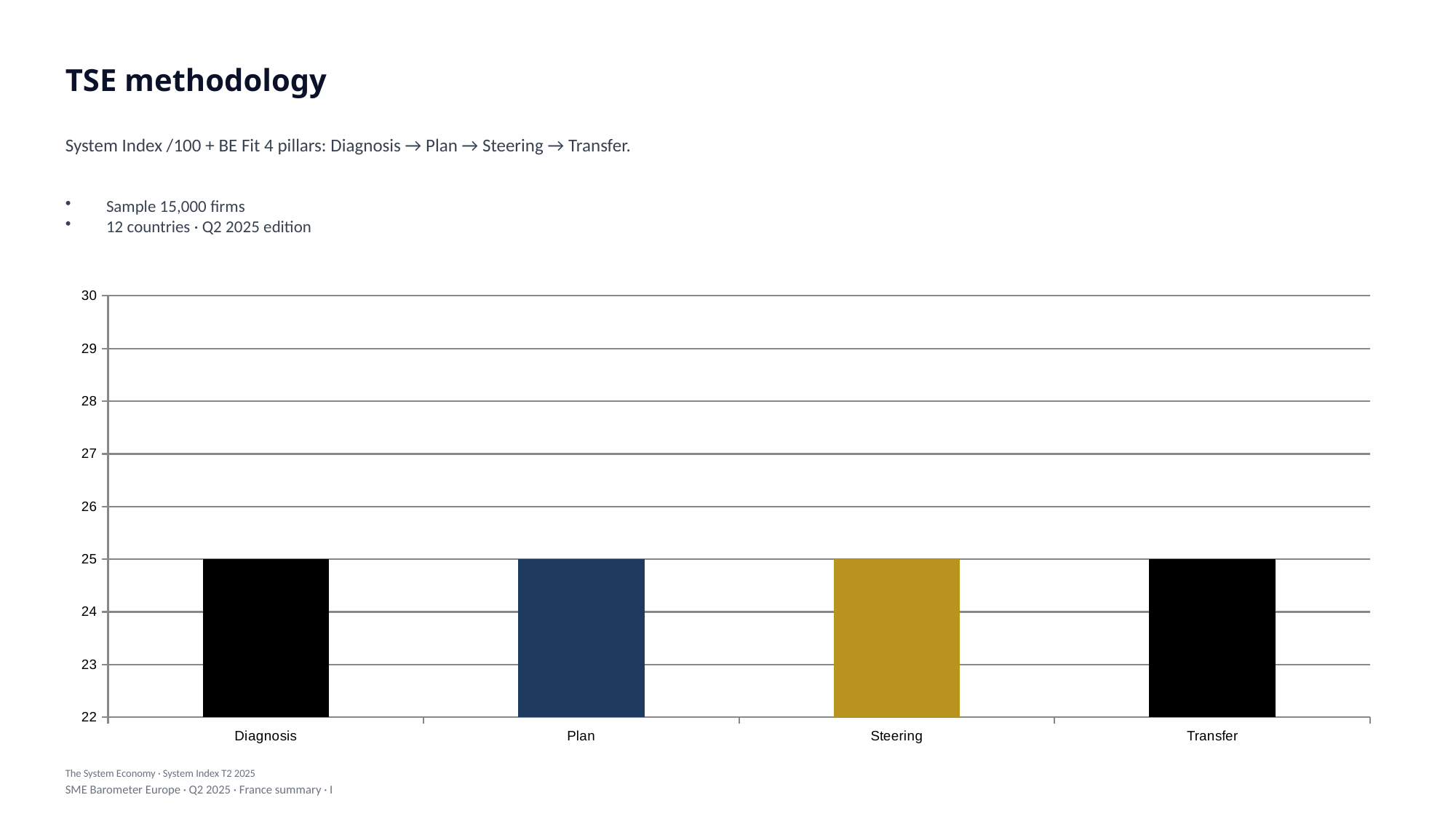
Is the value for Diagnosis greater or less than 24? greater What is the lowest value shown on the chart's vertical axis? 22 What is the difference between the values for Plan and Transfer? 0 What is the value for Plan? 25 What kind of chart is shown on the slide? bar chart Is the value for Steering greater or less than 27? less What colour is the bar for Steering? gold What is the value for Steering? 25 What is the value for Transfer? 25 What is the value for Diagnosis? 25 Do the values rise, fall or stay flat from Diagnosis to Transfer? stay flat How many categories are shown on the x axis of the chart? 4